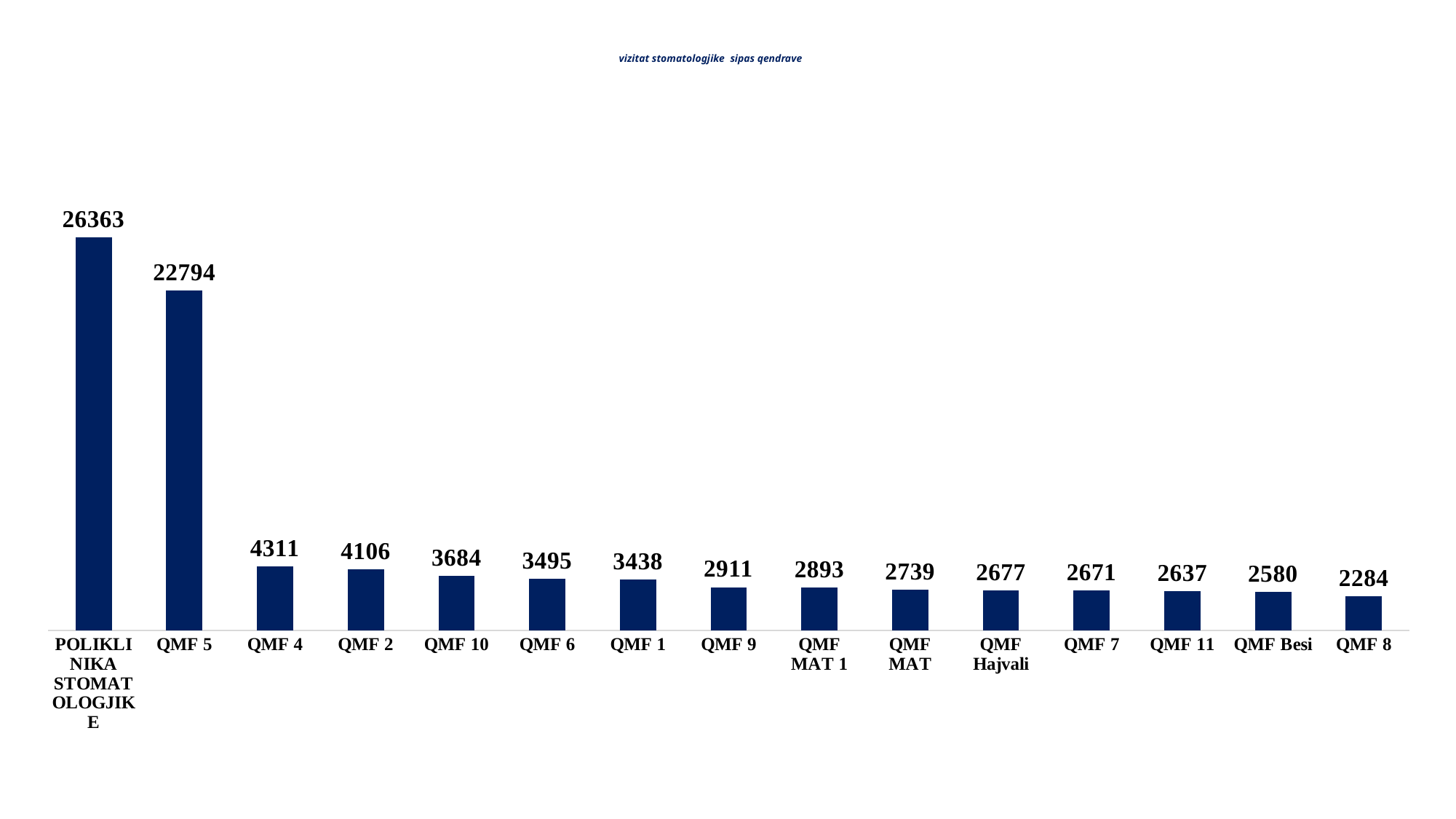
What is the difference between the values for POLIKLINIKA STOMATOLOGJIKE and QMF 5? 3569 What is the value for QMF 10? 3684 What is the value for QMF Hajvali? 2677 Do the values rise or fall from left to right along the x axis? Fall Which category has the highest value? POLIKLINIKA STOMATOLOGJIKE How many categories are shown on the x axis? 15 What is the difference between the values for QMF 4 and QMF 2? 205 What is the title of the chart? vizitat stomatologjike sipas qendrave What kind of chart is this? Bar chart What is the value for QMF 5? 22794 Which is larger, the value for QMF 6 or the value for QMF 9? QMF 6 Which category has the lowest value? QMF 8